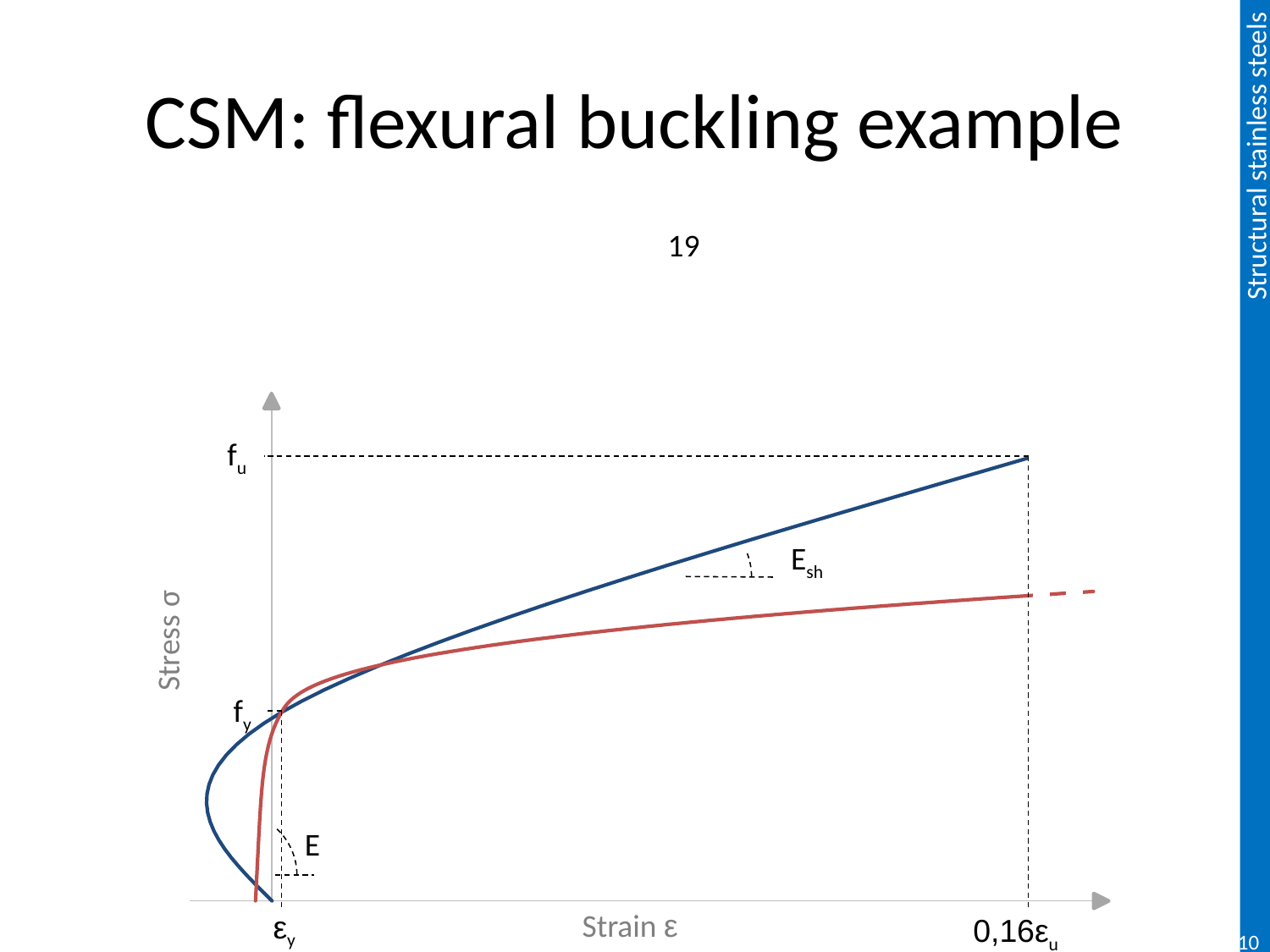
What kind of chart is shown on the slide? line chart What strain value is marked on the horizontal axis directly below f_y? ε_y How many curves are plotted on the stress-strain chart? 2 What label is given to the initial slope of the curve near the origin? E What label is given to the slope of the blue curve beyond f_y? E_sh What is the label of the horizontal axis? Strain ε What strain value is marked at the far right of the horizontal axis? 0,16ε_u What stress level is marked on the vertical axis at the strain ε_y? f_y Does the stress along the blue curve rise or fall as strain increases beyond f_y? rise What stress level does the blue curve reach at the strain 0,16ε_u? f_u What is the label of the vertical axis? Stress σ At the strain 0,16ε_u, which curve has the higher stress, the blue one or the red one? blue